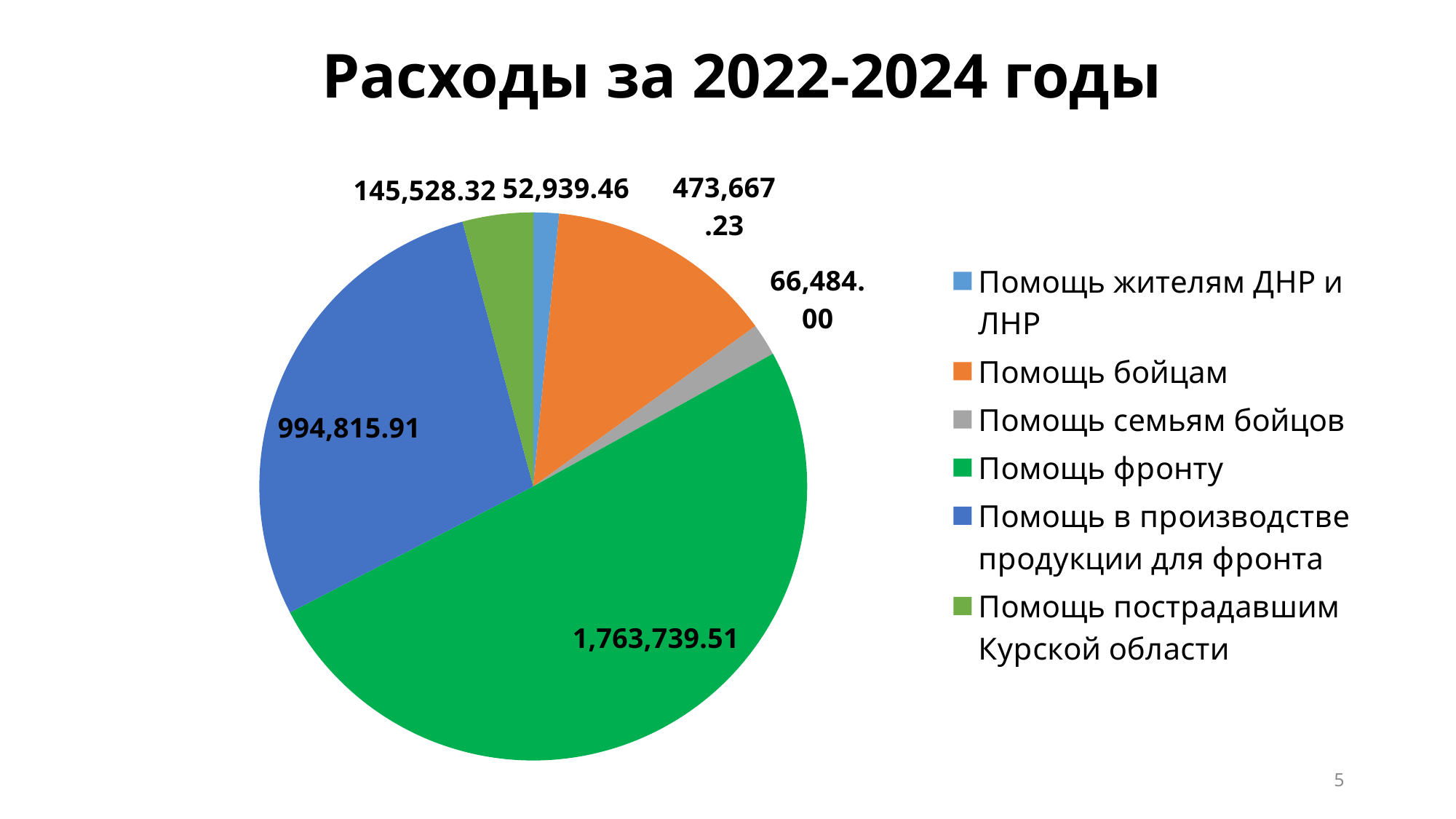
What is the difference between the values for Помощь фронту and Помощь в производстве продукции для фронта? 768,923.60 What is the value for Помощь пострадавшим Курской области? 145,528.32 How many categories does the pie chart have? 6 What kind of chart is shown on the slide? Pie chart What is the title of the chart? Расходы за 2022-2024 годы What is the value for Помощь семьям бойцов? 66,484.00 Which is larger: Помощь бойцам or Помощь пострадавшим Курской области? Помощь бойцам What is the value for Помощь фронту? 1,763,739.51 Which category has the smallest slice of the pie? Помощь жителям ДНР и ЛНР What is the value for Помощь в производстве продукции для фронта? 994,815.91 What is the value for Помощь бойцам? 473,667.23 Which category has the largest slice of the pie? Помощь фронту